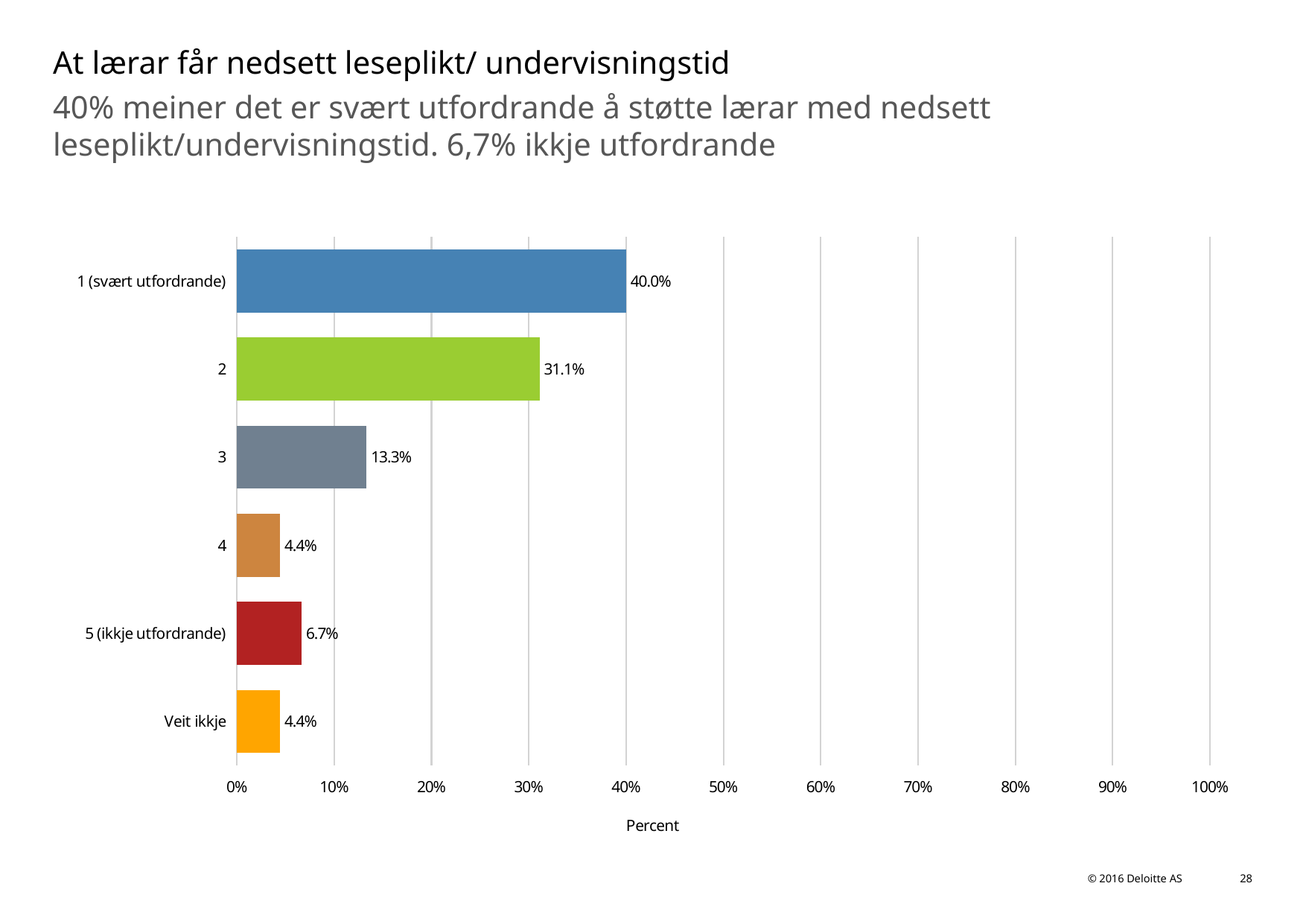
What is the value for "Veit ikkje"? 4.4% What is the value for category "2"? 31.1% What is the label of the horizontal axis? Percent What is the difference between the values for "1 (svært utfordrande)" and "2"? 8.9% Is the value for category "2" greater or less than 30%? greater How many categories are shown in the chart? 6 Which category has the highest value? 1 (svært utfordrande) What is the difference between the values for "3" and "5 (ikkje utfordrande)"? 6.6% Which is larger, the value for "3" or the value for "4"? 3 What is the value for "1 (svært utfordrande)"? 40.0% What kind of chart is shown on the slide? bar chart What is the value for "5 (ikkje utfordrande)"? 6.7%